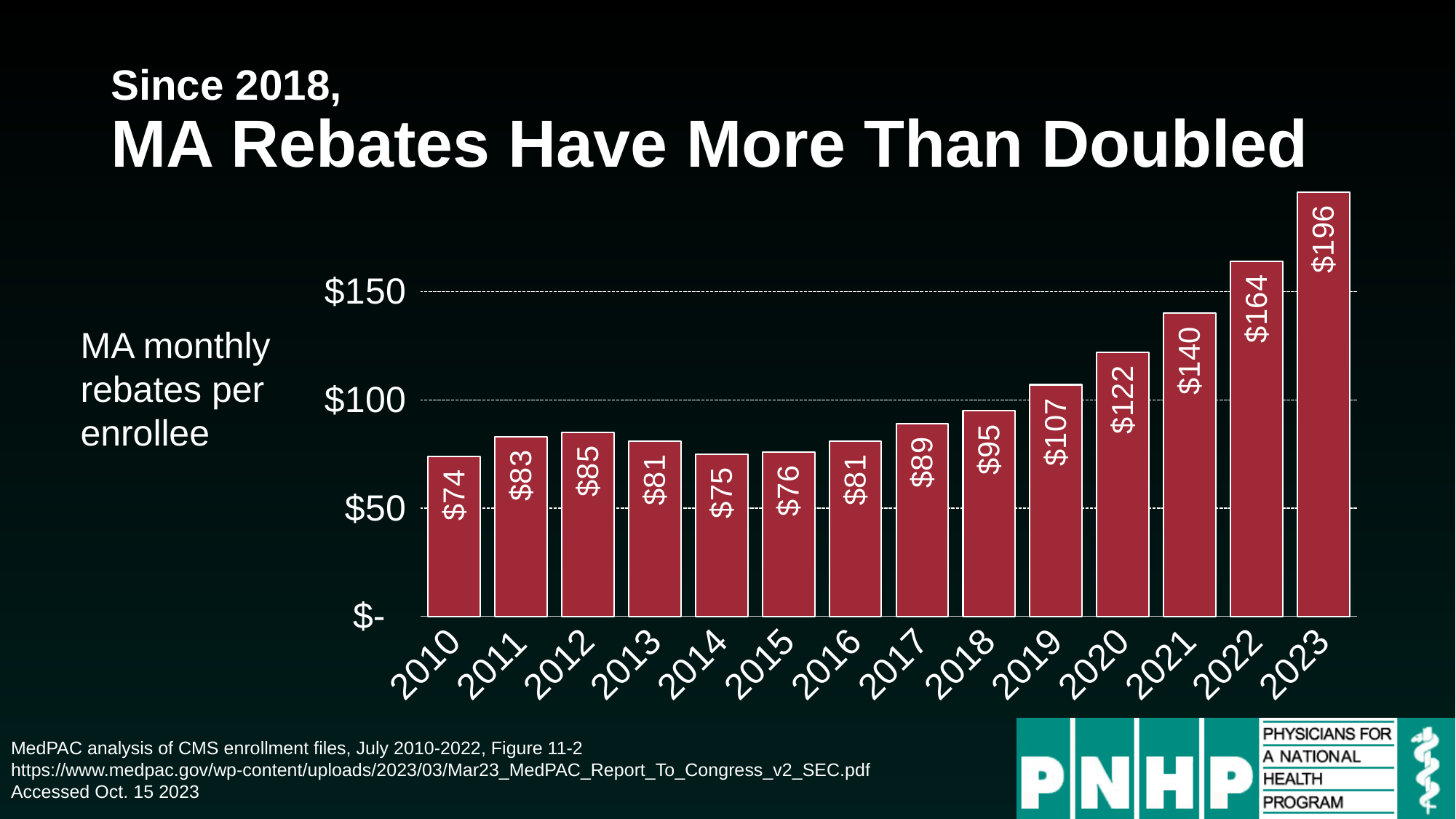
How many years are shown on the x axis of the chart? 14 Which year has the lowest MA monthly rebate per enrollee? 2010 What is the MA monthly rebate per enrollee for 2023? $196 What kind of chart is shown on the slide? bar chart What is the difference between the MA monthly rebate per enrollee in 2022 and in 2021? $24 What is the difference between the MA monthly rebate per enrollee in 2023 and in 2018? $101 Which year has the highest MA monthly rebate per enrollee? 2023 What is the MA monthly rebate per enrollee for 2010? $74 Which year has a larger MA monthly rebate per enrollee, 2012 or 2016? 2012 What is the MA monthly rebate per enrollee for 2018? $95 Do the MA monthly rebates per enrollee generally rise or fall from 2018 to 2023? rise Is the value for 2021 greater or less than $150? less